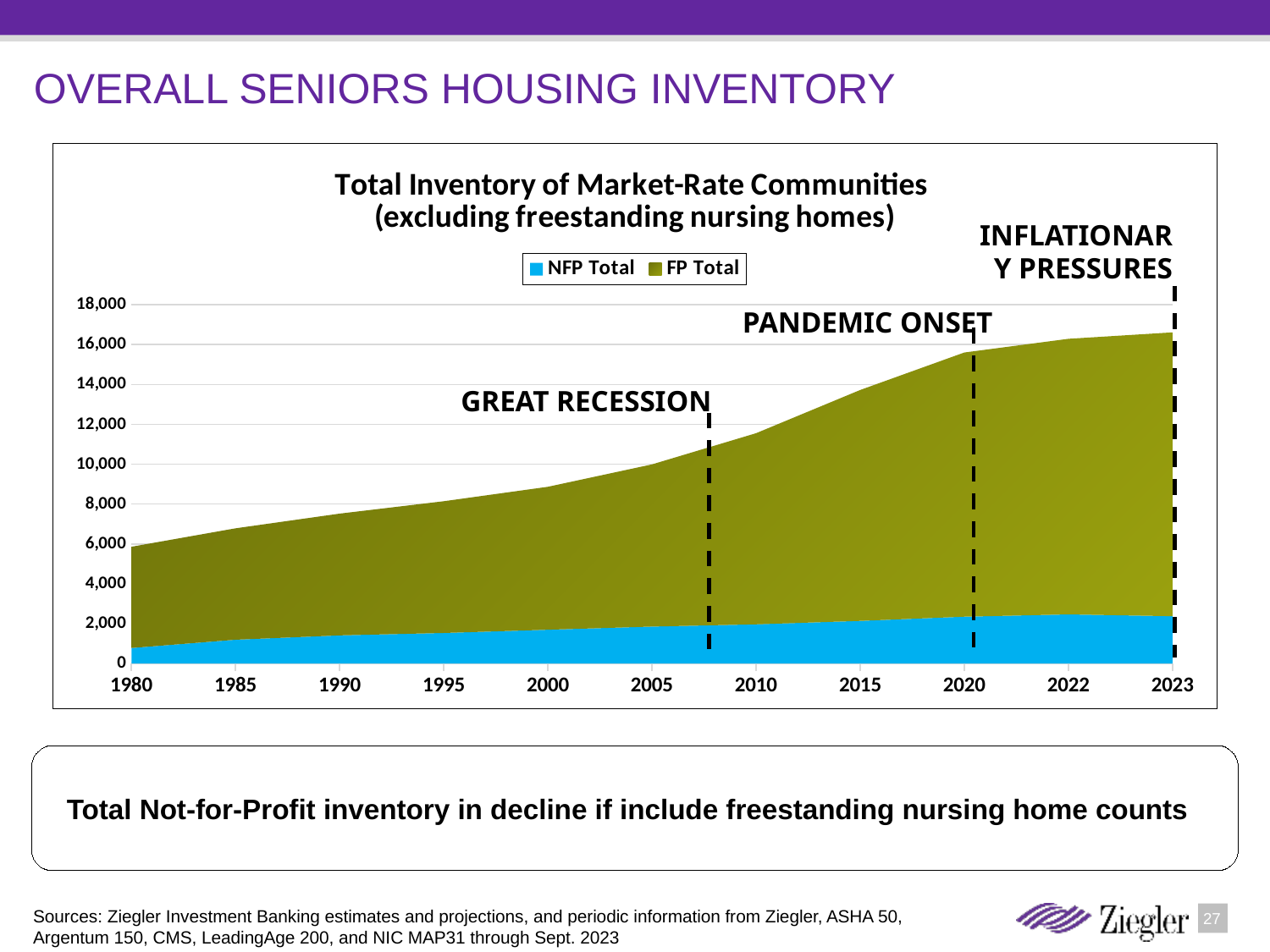
Which series is larger in 2023, NFP Total or FP Total? FP Total Is the NFP Total in 1980 greater or less than 2,000? less How many series does the legend list? 2 How many year labels are shown on the x axis? 11 Is the total inventory in 2000 greater or less than 8,000? greater What is the title of the chart? Total Inventory of Market-Rate Communities (excluding freestanding nursing homes) Is the total inventory in 2023 greater or less than 16,000? greater What kind of chart is shown on the slide? Stacked area chart Does the total inventory rise or fall from 1980 to 2023? Rise What are the two series named in the legend? NFP Total and FP Total